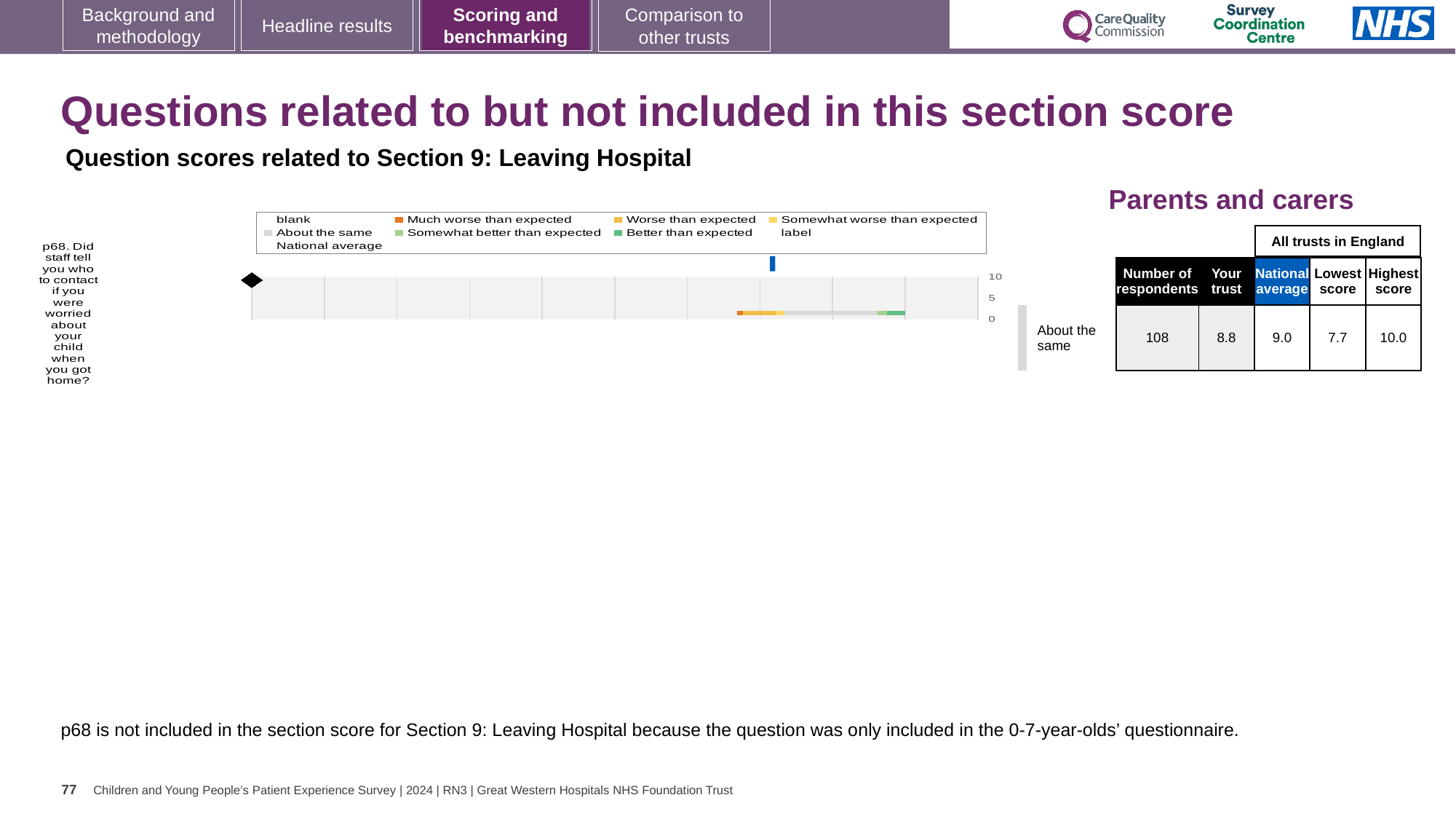
What is the difference between the highest and lowest trust scores in England for p68? 2.3 What benchmarking category is the trust's result for p68 placed in? About the same Which is larger for p68, the trust's score or the national average? National average Which legend entry is shown in orange? Much worse than expected What is the national average score for question p68? 9.0 What kind of chart is used to show the benchmarking result for question p68? bar chart How many respondents answered question p68? 108 How many entries does the chart legend list? 9 What is the 'Your trust' score for question p68? 8.8 What is the highest tick value shown on the chart's score axis? 10 What is the difference between the national average and the trust's score for p68? 0.2 How many questions are plotted in the chart? 1